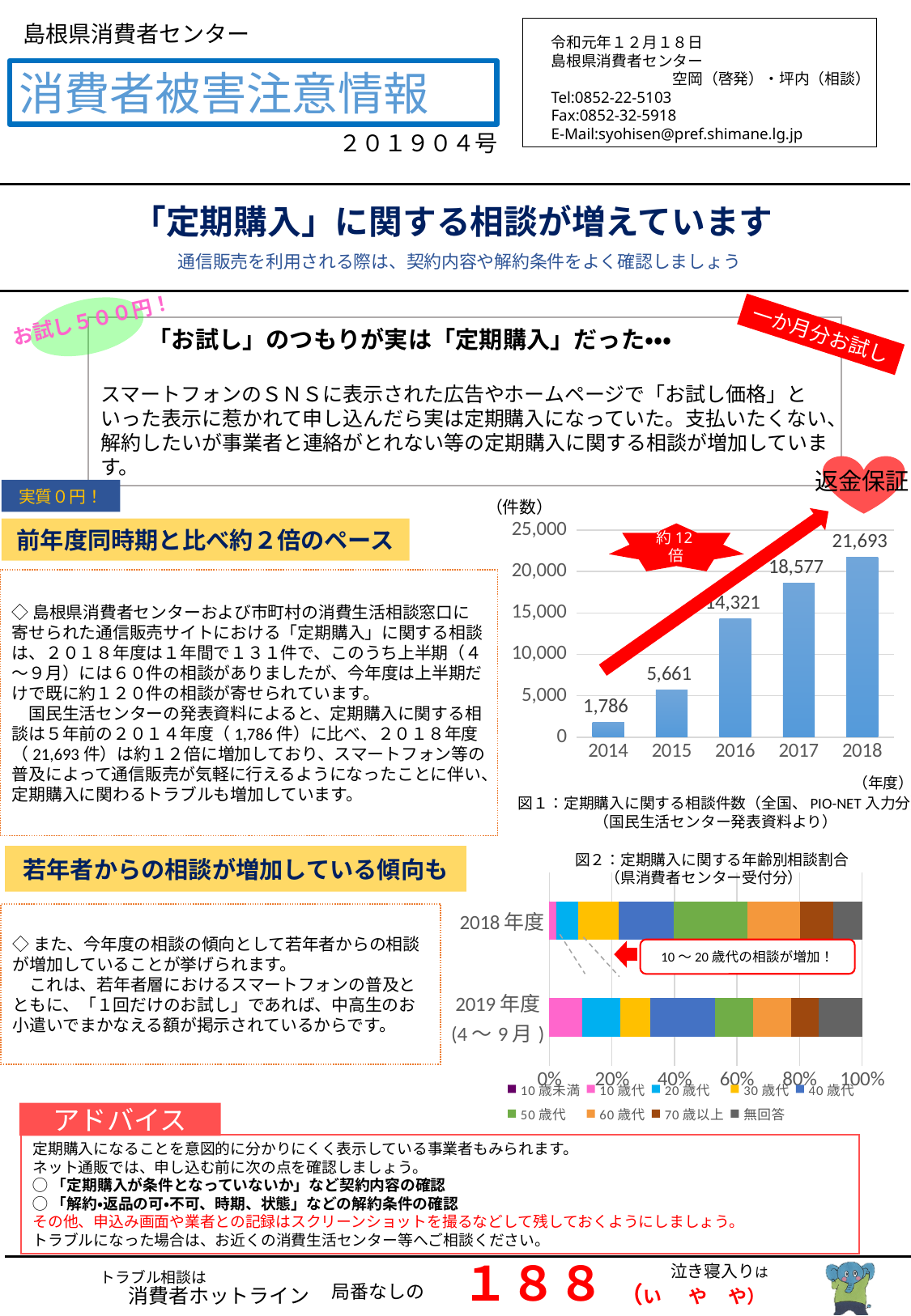
What kind of chart is Figure 2 (定期購入に関する年齢別相談割合)? stacked bar chart In Figure 1 (定期購入に関する相談件数), what is the number of consultations for 2014? 1,786 In Figure 1 (定期購入に関する相談件数), which year has the highest number of consultations? 2018 In Figure 1 (定期購入に関する相談件数), what is the difference between the 2018 and 2014 values? 19,907 In Figure 1 (定期購入に関する相談件数), how many years are shown on the x axis? 5 In Figure 1 (定期購入に関する相談件数), what is the number of consultations for 2018? 21,693 In Figure 1 (定期購入に関する相談件数), what is the difference between the 2017 and 2016 values? 4,256 In Figure 1 (定期購入に関する相談件数), which year has the lowest number of consultations? 2014 In Figure 1 (定期購入に関する相談件数), which is larger, the value for 2015 or the value for 2017? 2017 In Figure 1 (定期購入に関する相談件数), what is the value for 2016? 14,321 In Figure 1 (定期購入に関する相談件数), do the values rise or fall from 2014 to 2018? rise In Figure 2 (定期購入に関する年齢別相談割合), how many age groups does the legend list? 9